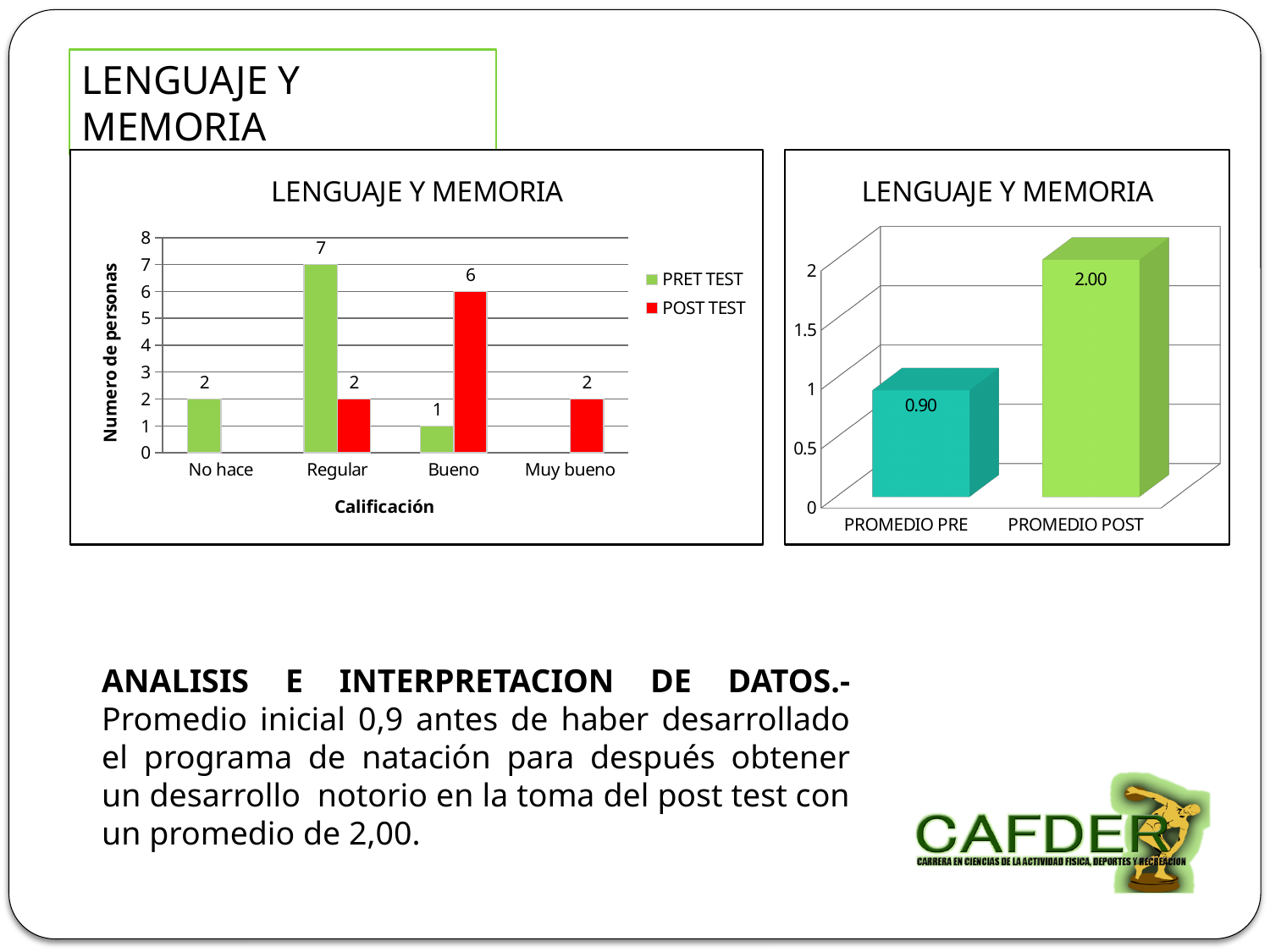
In the right chart, what is the difference between PROMEDIO POST and PROMEDIO PRE? 1.10 In the left chart, what is the PRET TEST value for Regular? 7 How many categories are shown on the x axis of the left chart? 4 In the left chart, what is the POST TEST value for Bueno? 6 In the right chart, what is the value for PROMEDIO PRE? 0.90 In the left chart, which is larger for Regular: PRET TEST or POST TEST? PRET TEST In the left chart, which category has the highest PRET TEST value? Regular How many series does the legend of the left chart list? 2 In the left chart, which category has the lowest non-zero PRET TEST value? Bueno In the left chart, what is the PRET TEST value for No hace? 2 In the left chart, what is the difference between the POST TEST and PRET TEST values for Bueno? 5 What kind of chart is the right chart? Bar chart